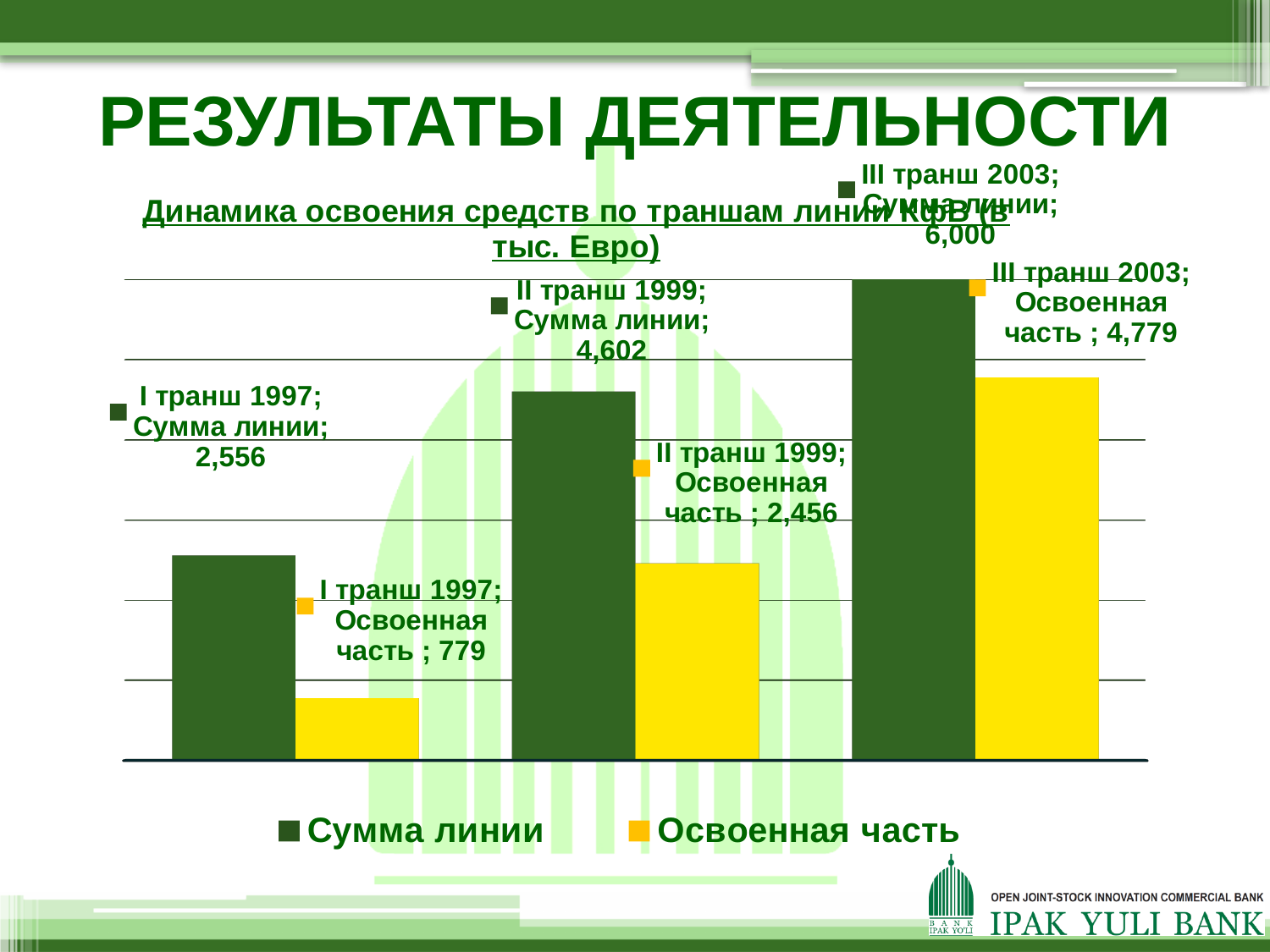
What is the value of Сумма линии for III транш 2003? 6,000 What is the difference between Сумма линии and Освоенная часть for III транш 2003? 1,221 What is the value of Освоенная часть for I транш 1997? 779 Which tranche has the highest Сумма линии? III транш 2003 What is the difference between Сумма линии and Освоенная часть for II транш 1999? 2,146 What kind of chart is shown on the slide? Bar chart What is the value of Сумма линии for I транш 1997? 2,556 What is the value of Освоенная часть for II транш 1999? 2,456 Which tranche has the lowest Освоенная часть? I транш 1997 How many series does the legend list? 2 Which is larger: Освоенная часть for III транш 2003 or Сумма линии for II транш 1999? Освоенная часть for III транш 2003 How many tranches (categories) are shown in the chart? 3